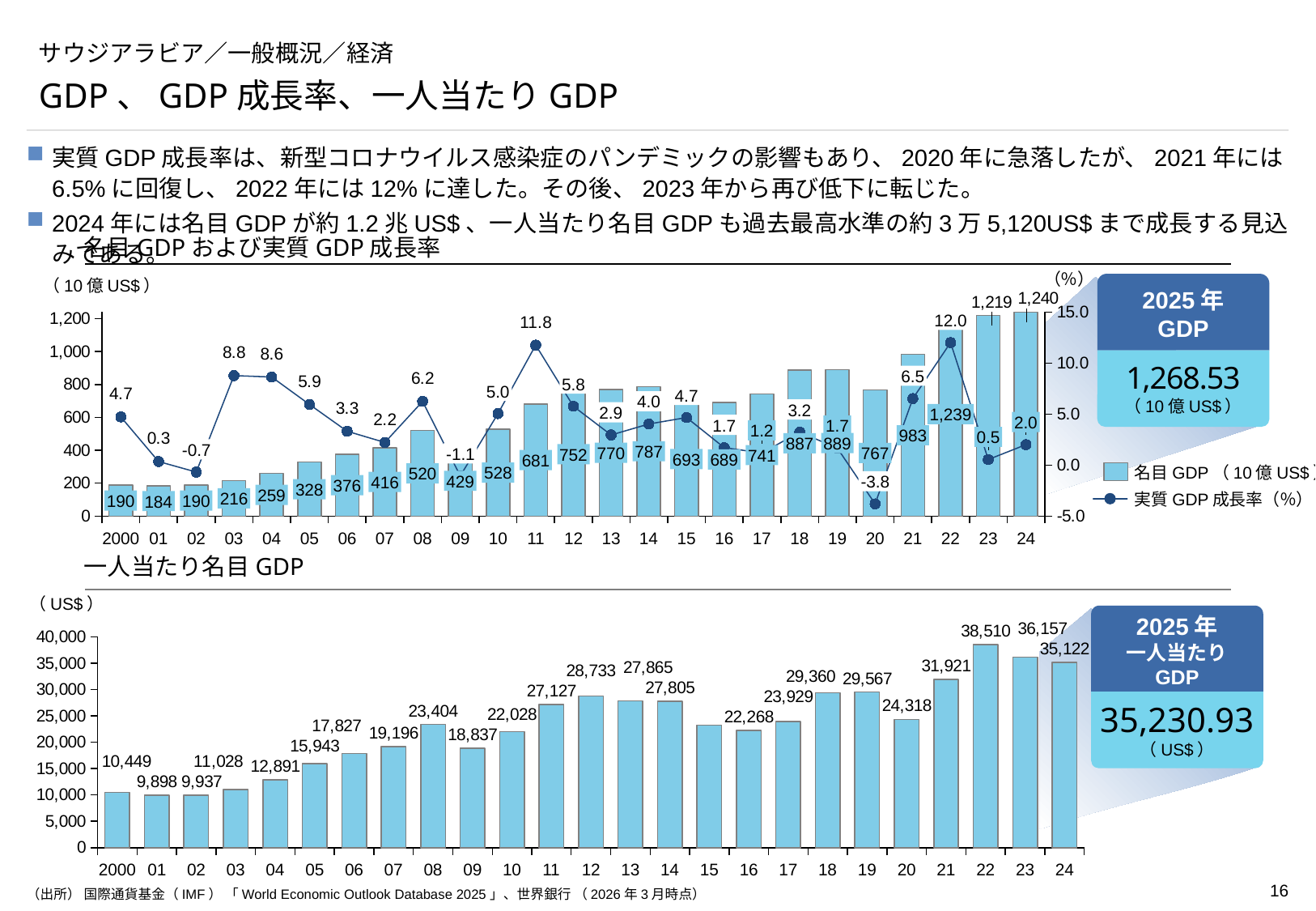
In the 名目GDPおよび実質GDP成長率 chart, what is the difference between nominal GDP in 2022 and 2021? 256 In the 一人当たり名目GDP chart, which year has the lowest value? 2001 In the 名目GDPおよび実質GDP成長率 chart, which year has the larger nominal GDP, 2008 or 2009? 2008 In the 一人当たり名目GDP chart, is the value for 2015 greater or less than 25,000? less In the 一人当たり名目GDP chart, what is the difference between the values for 2023 and 2024? 1,035 In the 名目GDPおよび実質GDP成長率 chart, what is the nominal GDP value for 2024? 1,240 What kind of chart is the 一人当たり名目GDP chart at the bottom of the slide? bar chart In the 名目GDPおよび実質GDP成長率 chart, what is the real GDP growth rate for 2022? 12.0 In the 一人当たり名目GDP chart, which year has the highest value? 2022 In the 名目GDPおよび実質GDP成長率 chart, which year has the lowest real GDP growth rate? 2020 How many years are plotted on the x axis of the 一人当たり名目GDP chart? 25 In the 名目GDPおよび実質GDP成長率 chart, how many series does the legend list? 2